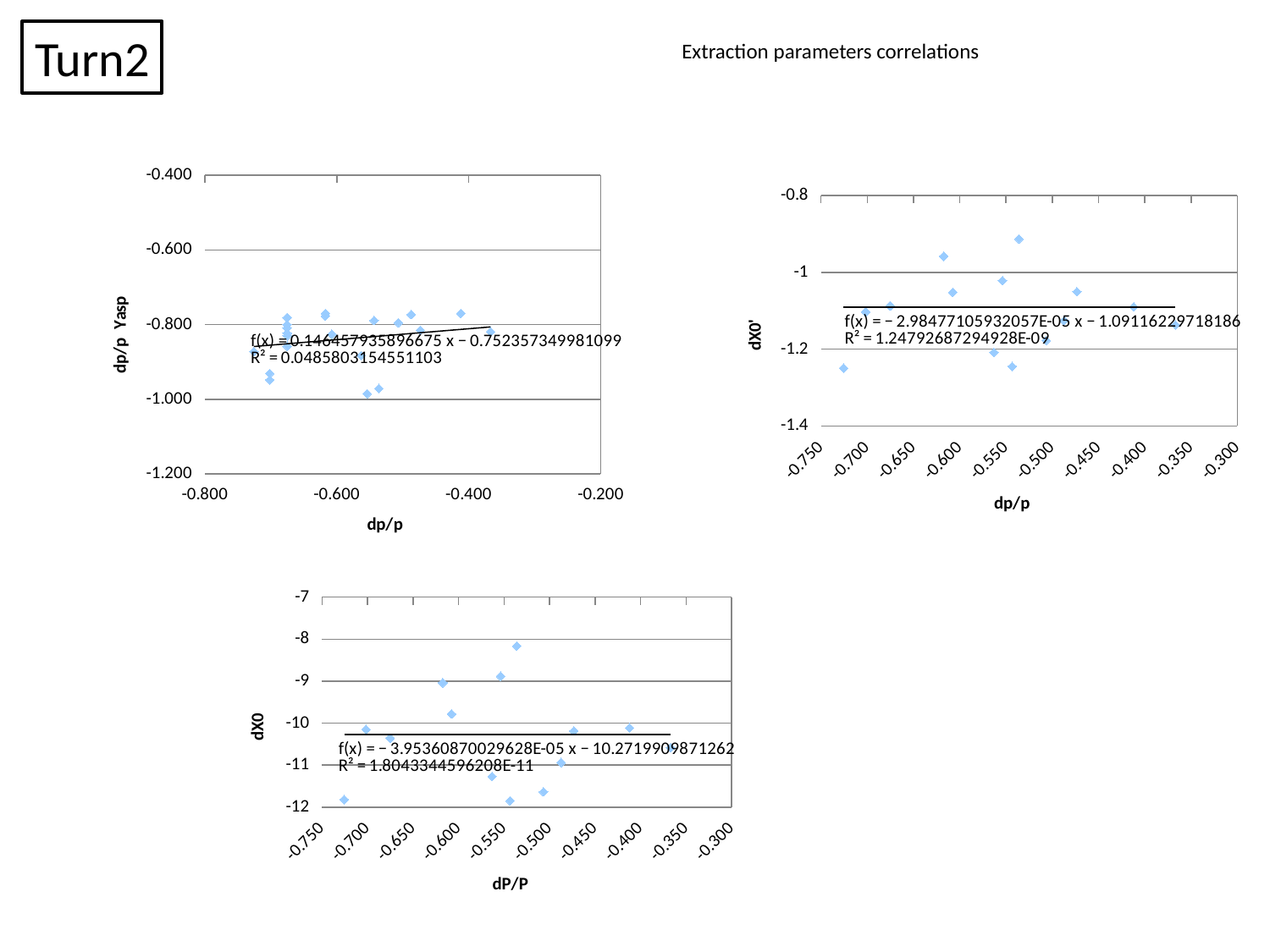
How many charts are shown on the slide? 3 In the bottom-left chart (y-axis dX0), is the highest plotted point greater or less than -9? greater In the top-right chart (y-axis dX0'), is the highest plotted point greater or less than -1? greater In the top-right chart (y-axis dX0'), is the lowest plotted point greater or less than -1.2? less What kind of chart is the top-left chart with y-axis 'dp/p Yasp'? scatter chart In the bottom-left chart (y-axis dX0), does the fitted trendline rise or fall as dP/P increases? falls What is the minimum value shown on the y-axis of the bottom-left chart (dX0)? -12 In the top-left chart, what is the title of the y-axis? dp/p Yasp In the bottom-left chart, what is the title of the x-axis? dP/P In the top-left chart (y-axis dp/p Yasp), does the fitted trendline rise or fall as dp/p increases? rises